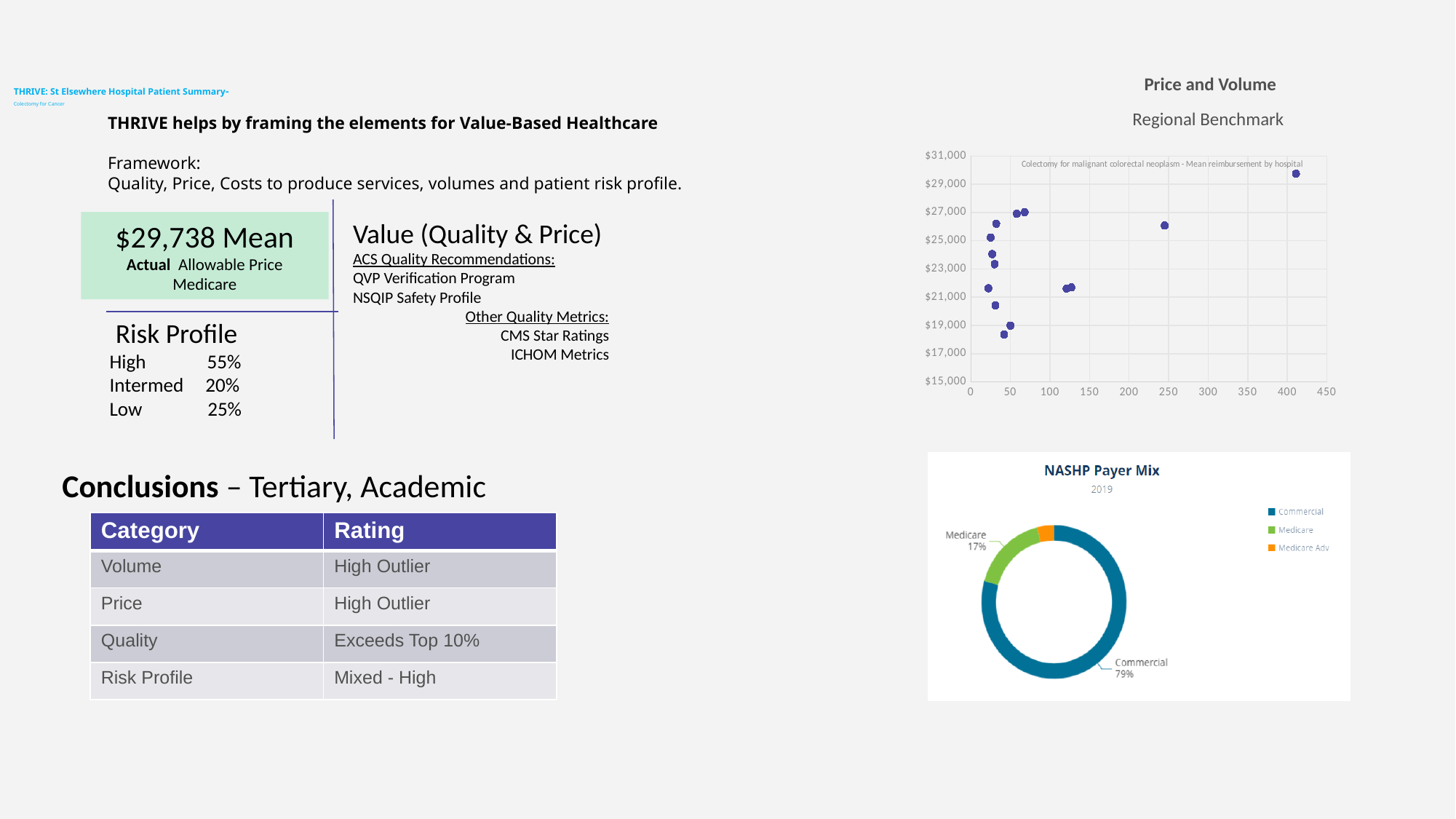
How many entries does the legend of the NASHP Payer Mix chart list? 3 In the NASHP Payer Mix chart, what share of the payer mix is Commercial? 79% In the Price and Volume Regional Benchmark chart, is the mean reimbursement of the rightmost point (at a volume of about 400) greater or less than $29,000? greater In the NASHP Payer Mix chart, what share of the payer mix is Medicare? 17% What kind of chart is the NASHP Payer Mix chart? Pie (donut) chart What year is shown under the title of the NASHP Payer Mix chart? 2019 In the Price and Volume Regional Benchmark chart, is the mean reimbursement of the lowest point greater or less than $19,000? less In the NASHP Payer Mix chart, which is larger: the Commercial share or the Medicare share? Commercial What kind of chart is the Price and Volume Regional Benchmark chart? Scatter chart In the NASHP Payer Mix chart, how many percentage points larger is the Commercial share than the Medicare share? 62 percentage points In the NASHP Payer Mix chart, which payer has the smallest share? Medicare Adv In the NASHP Payer Mix chart, which payer has the largest share? Commercial